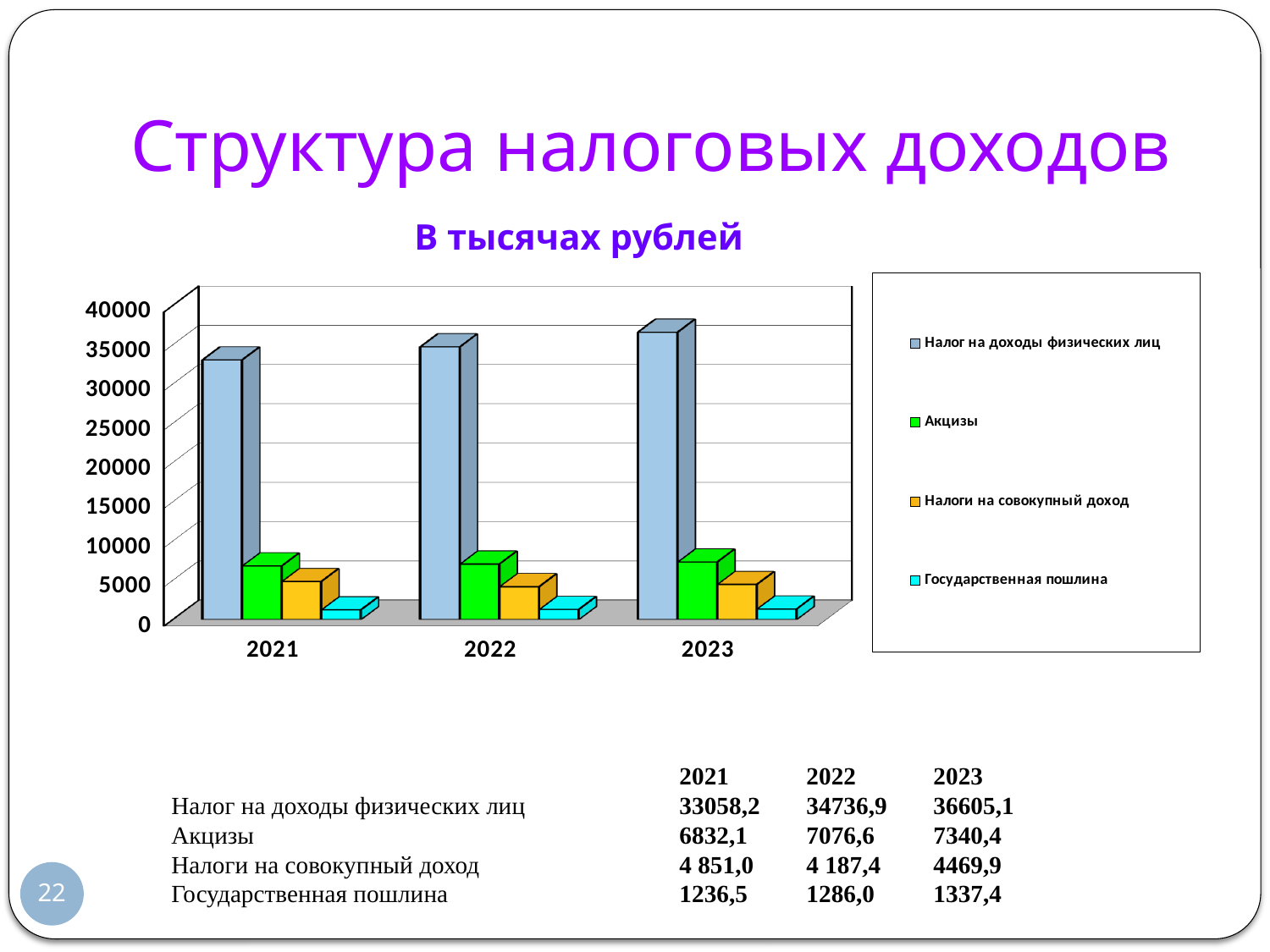
By how much did Налог на доходы физических лиц increase from 2021 to 2023? 3546,9 What is the value of Налог на доходы физических лиц for 2023? 36605,1 How many years are shown on the x axis of the chart? 3 Is the value for Налог на доходы физических лиц in 2023 greater or less than 35000? greater How many series does the legend list? 4 Which is larger: Налоги на совокупный доход in 2021 or in 2022? 2021 What type of chart is shown on the slide? bar chart What is the value of Акцизы for 2021? 6832,1 Does the value of Акцизы rise or fall from 2021 to 2023? rise Which series has the lowest value in 2023? Государственная пошлина Which series has the highest value in 2022? Налог на доходы физических лиц What is the value of Государственная пошлина for 2022? 1286,0